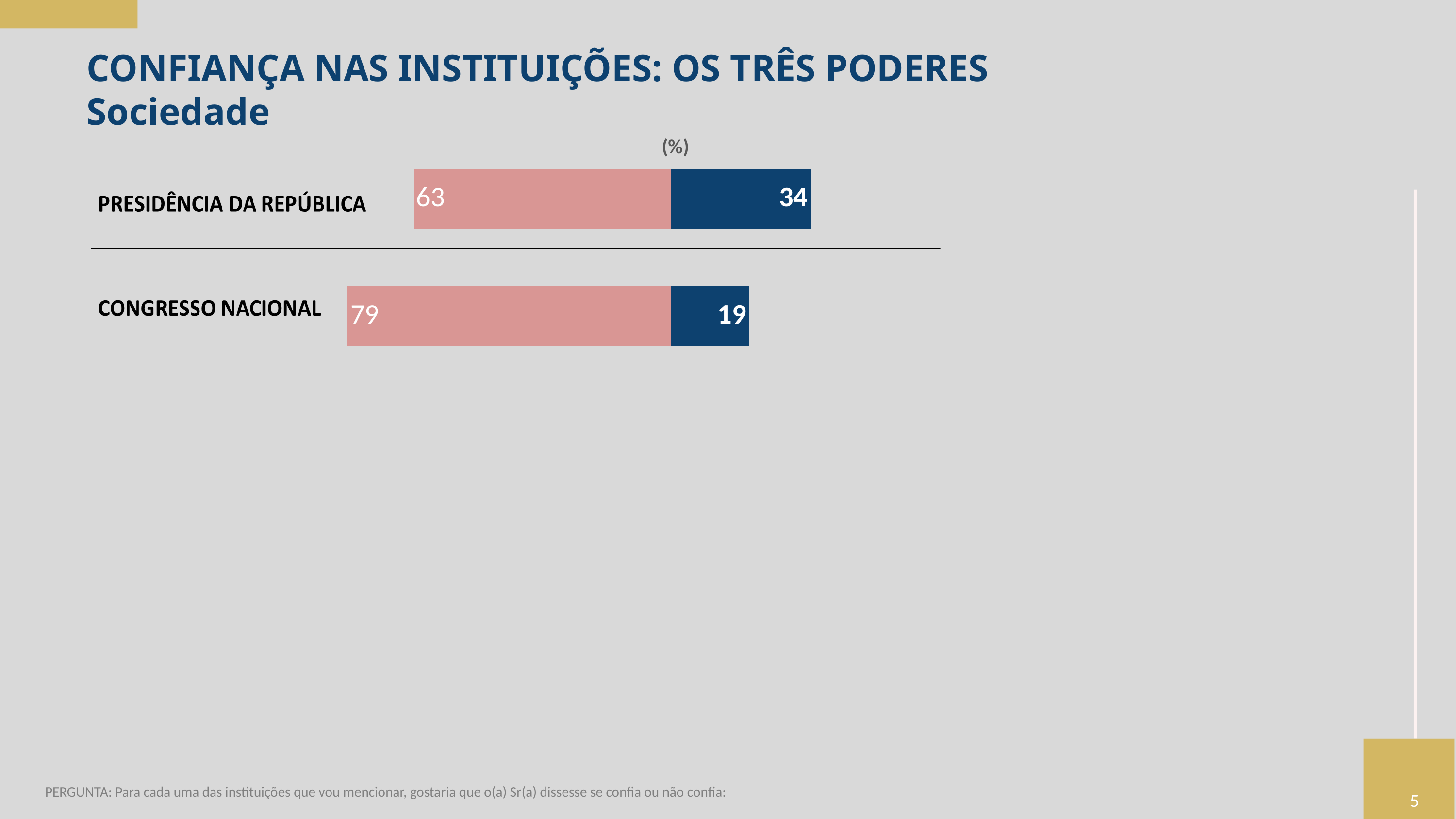
What is the value of the dark blue segment for CONGRESSO NACIONAL? 19 What kind of chart is shown on the slide? bar chart What is the value of the dark blue segment for PRESIDÊNCIA DA REPÚBLICA? 34 How many categories (institutions) does the chart show? 2 Which institution has the lower dark blue-segment value? CONGRESSO NACIONAL What unit label is shown above the chart? (%) What is the value of the pink segment for CONGRESSO NACIONAL? 79 What is the value of the pink segment for PRESIDÊNCIA DA REPÚBLICA? 63 What is the difference between the pink-segment values for CONGRESSO NACIONAL and PRESIDÊNCIA DA REPÚBLICA? 16 What is the difference between the dark blue-segment values for PRESIDÊNCIA DA REPÚBLICA and CONGRESSO NACIONAL? 15 Is the dark blue-segment value for PRESIDÊNCIA DA REPÚBLICA larger or smaller than that for CONGRESSO NACIONAL? larger Which institution has the higher pink-segment value? CONGRESSO NACIONAL